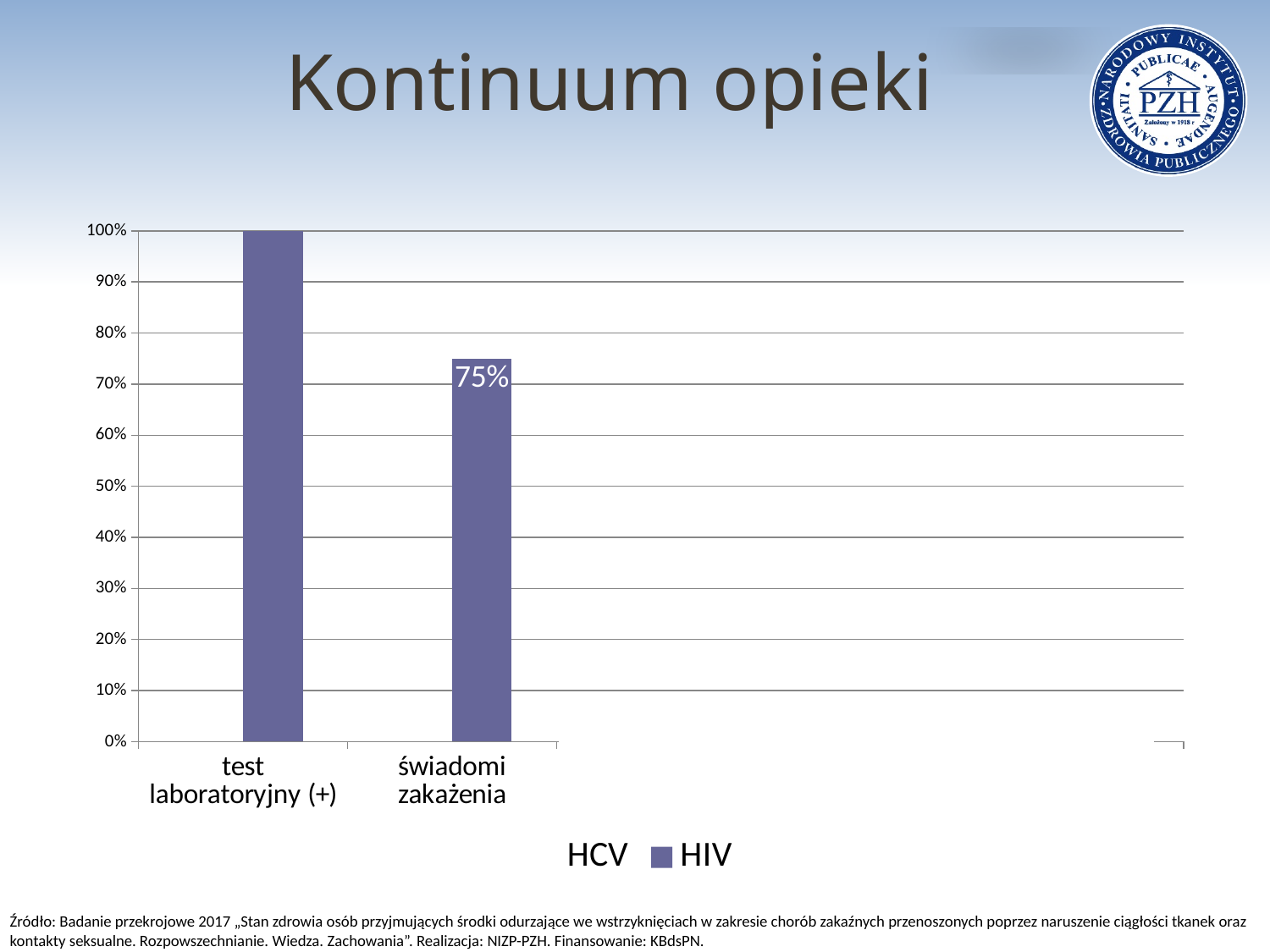
What kind of chart is shown on the slide? bar chart Is the value for "świadomi zakażenia" greater or less than 80%? less How many categories are labelled on the x axis of the chart? 2 What is the value for "świadomi zakażenia" in the chart? 75% What is the title of the slide containing the chart? Kontinuum opieki What is the value for "test laboratoryjny (+)" in the chart? 100% Which category has the highest value in the chart? test laboratoryjny (+) Which category has the lowest value in the chart? świadomi zakażenia Which is larger: the value for "test laboratoryjny (+)" or for "świadomi zakażenia"? test laboratoryjny (+) What is the difference between the values for "test laboratoryjny (+)" and "świadomi zakażenia"? 25% How many series does the chart legend list? 2 Do the values rise or fall from "test laboratoryjny (+)" to "świadomi zakażenia"? fall